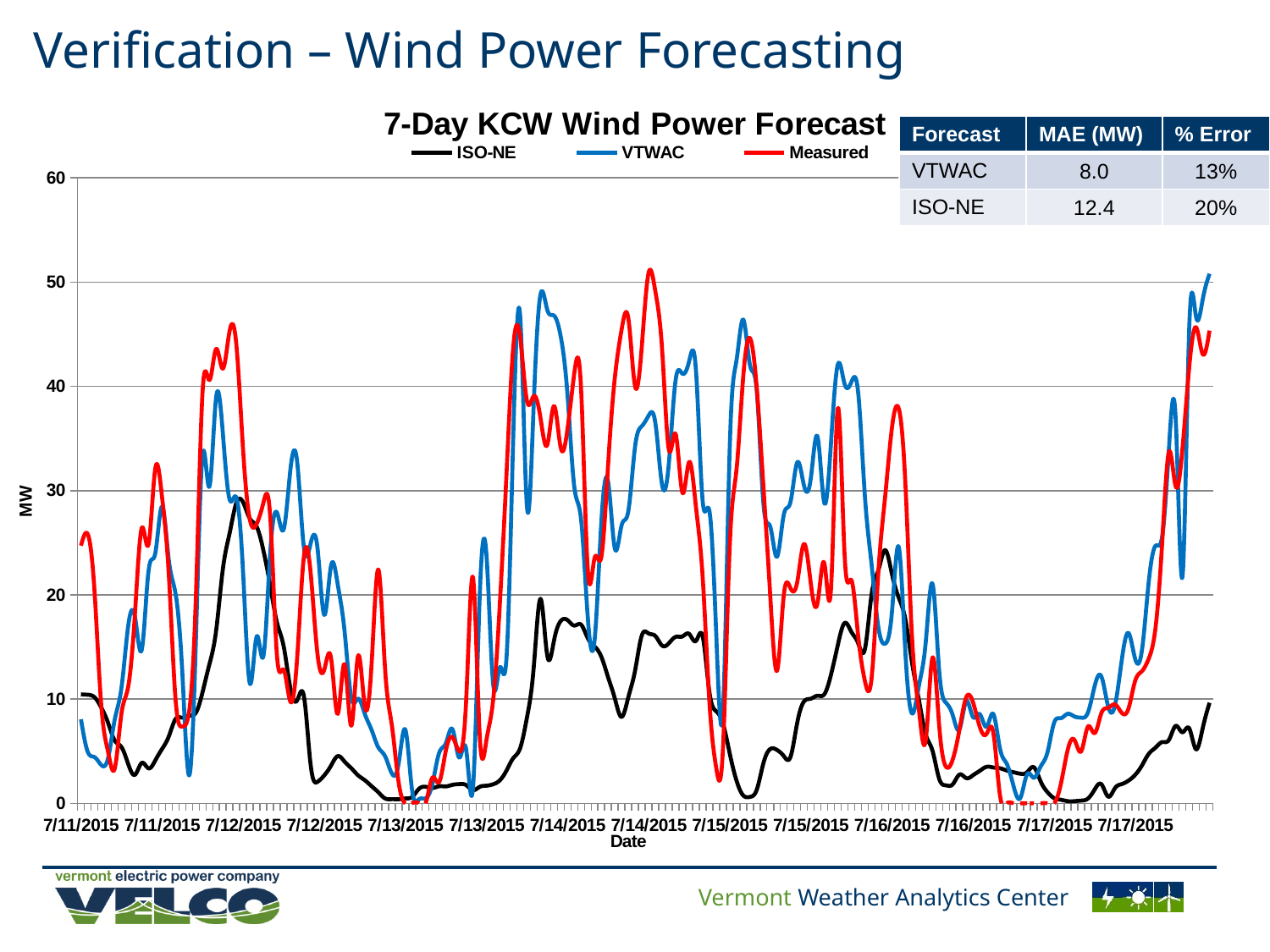
What is the highest value shown on the y axis of the chart? 60 In the table next to the chart, what is the MAE (MW) for VTWAC? 8.0 Is the highest value reached by the Measured line greater or less than 40? greater What kind of chart is shown on the slide? line chart Is the highest value reached by the ISO-NE line greater or less than 40? less Which series is drawn in red on the chart? Measured What is the label on the y axis of the chart? MW How many series does the chart legend list? 3 What is the title of the chart? 7-Day KCW Wind Power Forecast Is the highest value reached by the VTWAC line greater or less than 40? greater Over how many distinct dates does the x axis of the chart span? 7 In the table next to the chart, which forecast has the lower % Error, VTWAC or ISO-NE? VTWAC